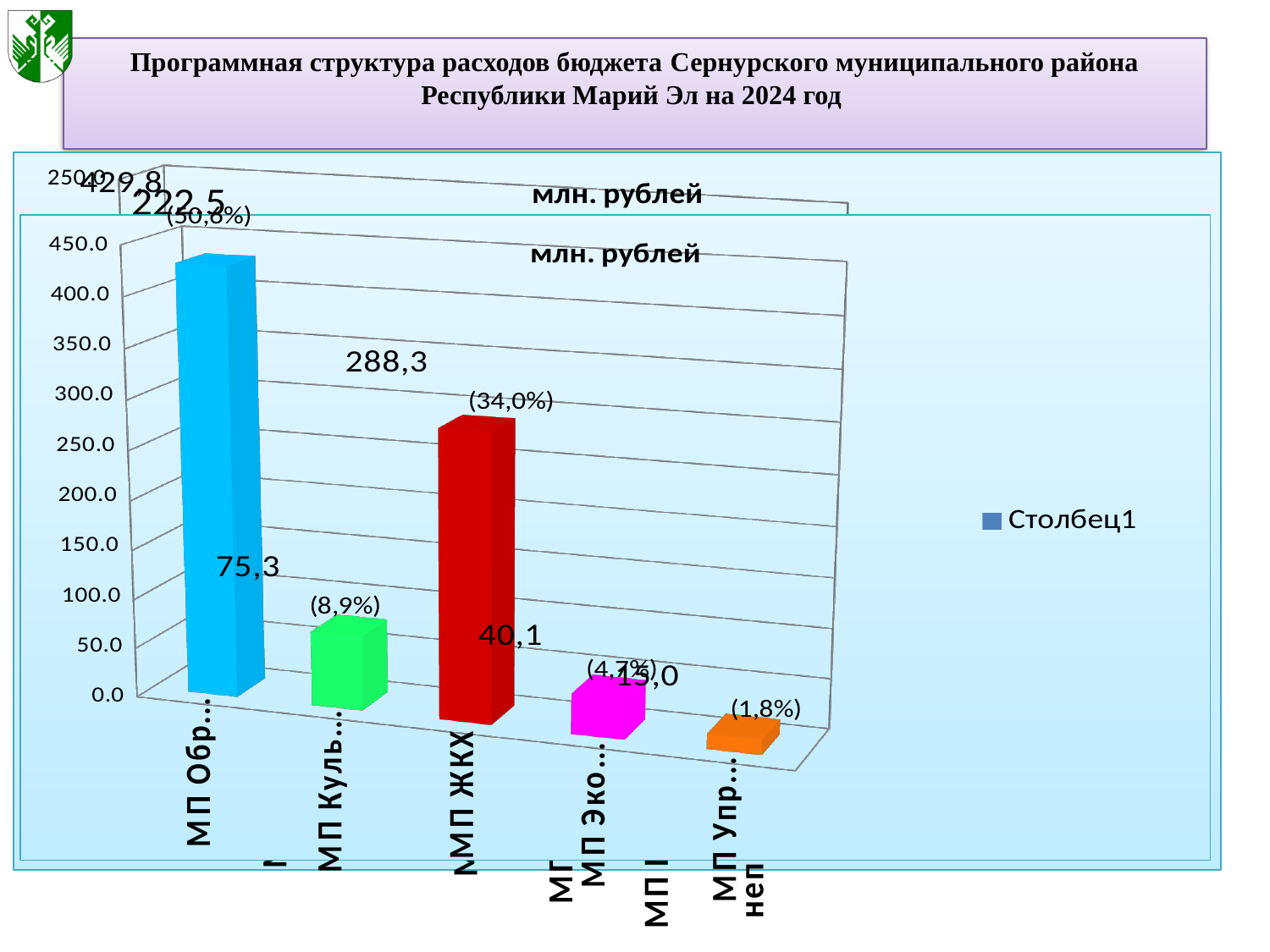
Which bar is the shortest in the chart? the orange bar (МП Упр…) What unit is stated above the chart's plot area? млн. рублей How many bars are plotted in the chart? 5 Which is larger, the green bar (МП Куль…) or the magenta bar (МП Эко…)? the green bar (МП Куль…) Which bar is the tallest in the chart? the blue bar (МП Обр…) What value is labelled on the red bar (МП ЖКХ)? 288,3 How many series does the legend list? 1 What percentage share is labelled on the tallest (blue) bar? 50,8% Is the value of the green bar (МП Куль…) greater or less than 100.0? less What percentage share is labelled on the red bar (МП ЖКХ)? 34,0% What is the legend entry shown to the right of the chart? Столбец1 What kind of chart is shown on the slide? bar chart